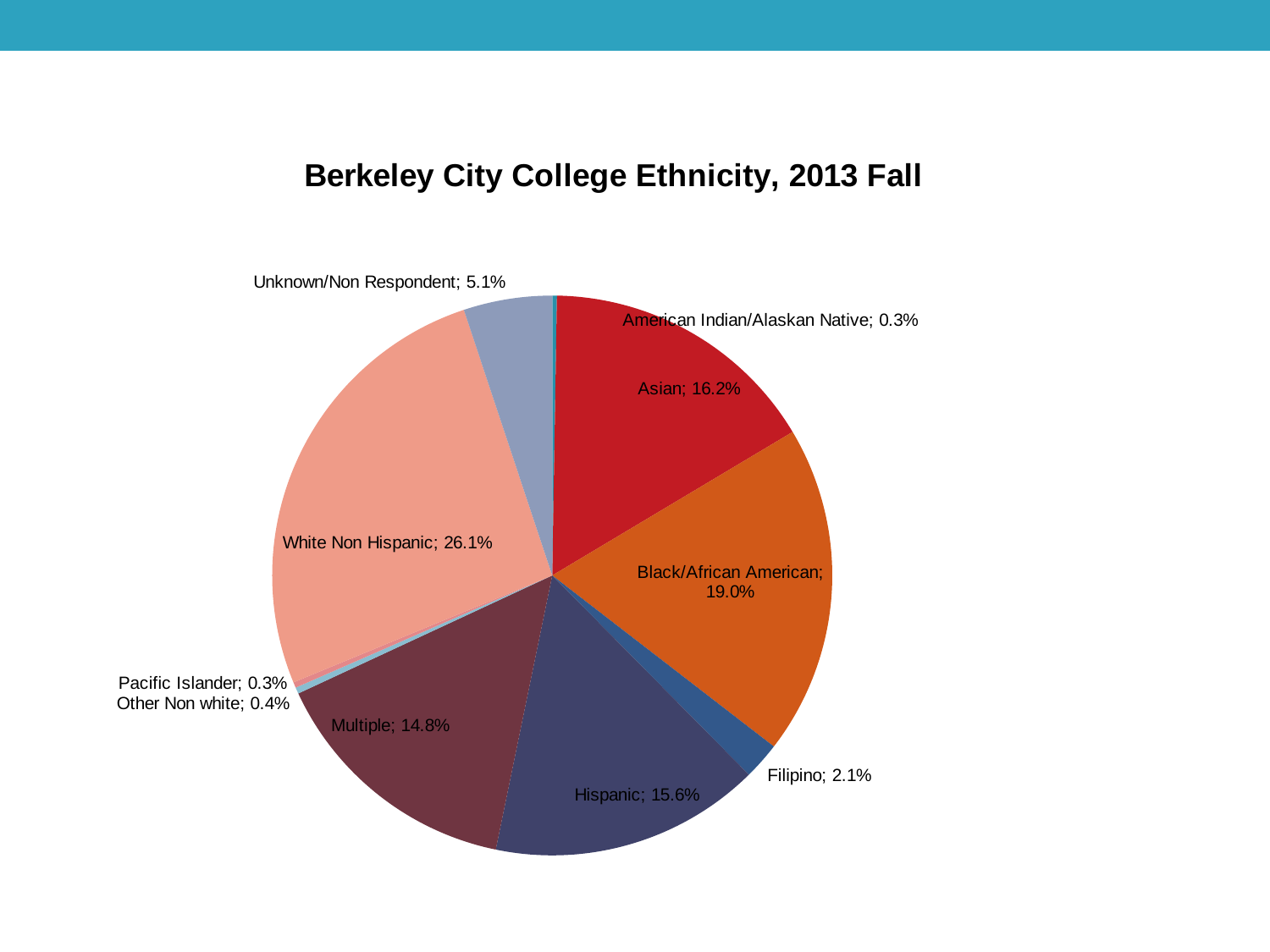
Which category has the largest share of the pie? White Non Hispanic What type of chart is shown on the slide? Pie chart What is the difference between the Hispanic and Multiple shares? 0.8% What is the value for Black/African American? 19.0% How many categories are shown in the pie chart? 10 What is the combined share of Asian and Black/African American? 35.2% What is the difference between the White Non Hispanic and Black/African American shares? 7.1% Which category is larger, Asian or Hispanic? Asian What is the value for Filipino? 2.1% What is the title of the chart? Berkeley City College Ethnicity, 2013 Fall What percentage of students are White Non Hispanic? 26.1% What is the value for Unknown/Non Respondent? 5.1%